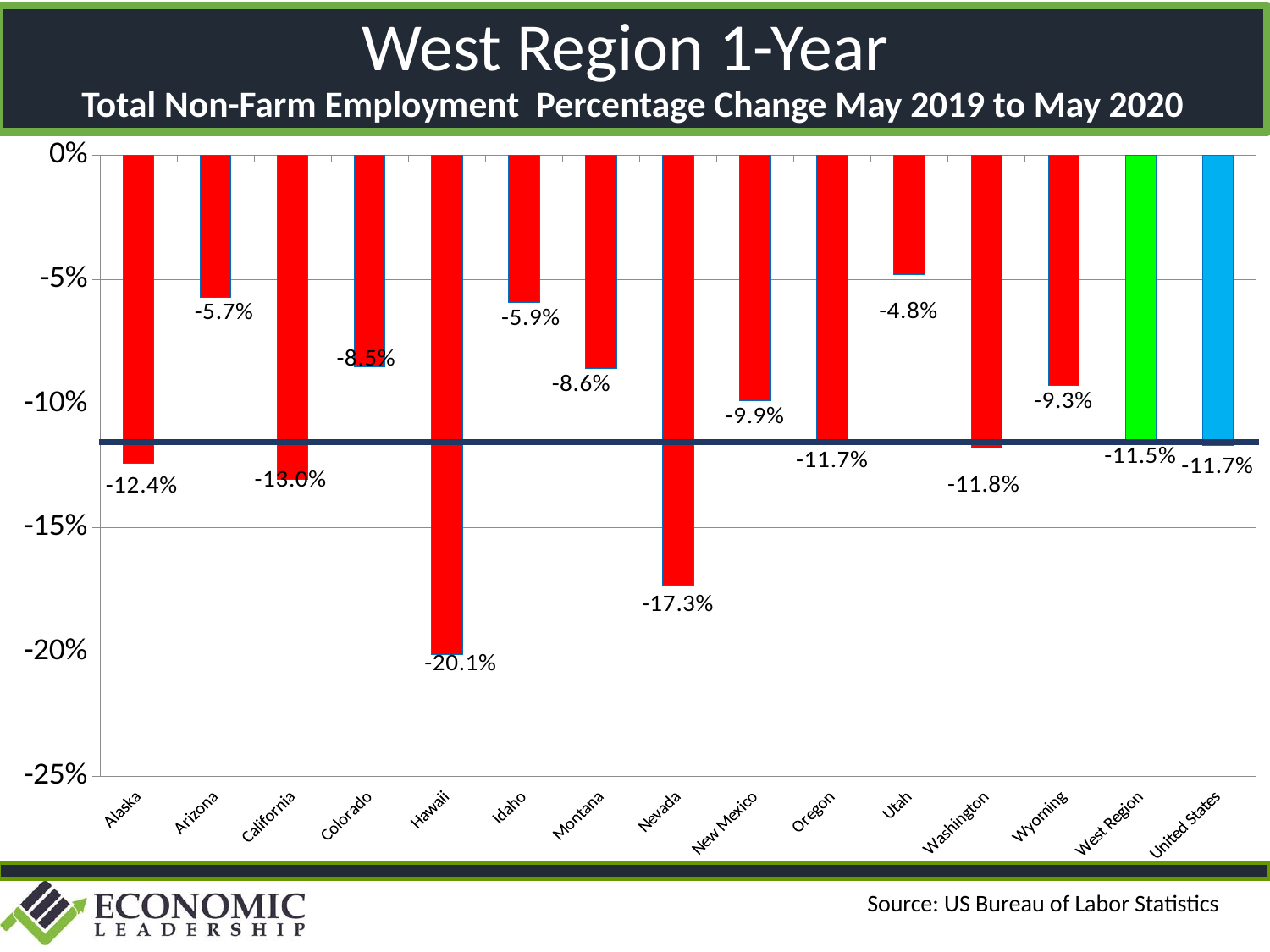
What is the percentage change in total non-farm employment for Hawaii? -20.1% What is the percentage change shown for Nevada? -17.3% Which state has the smallest employment decline (the highest value) on the chart? Utah Which state has the largest employment decline (the lowest value) on the chart? Hawaii How many bars are plotted on the chart? 15 What type of chart is shown on the slide? Bar chart What is the percentage change shown for Utah? -4.8% What colour is the bar for the West Region? Green What is the difference between the values for Hawaii and Utah? 15.3 percentage points Which has a larger decline, California or Alaska? California What value is shown for the West Region bar? -11.5% What is the percentage change shown for the United States? -11.7%